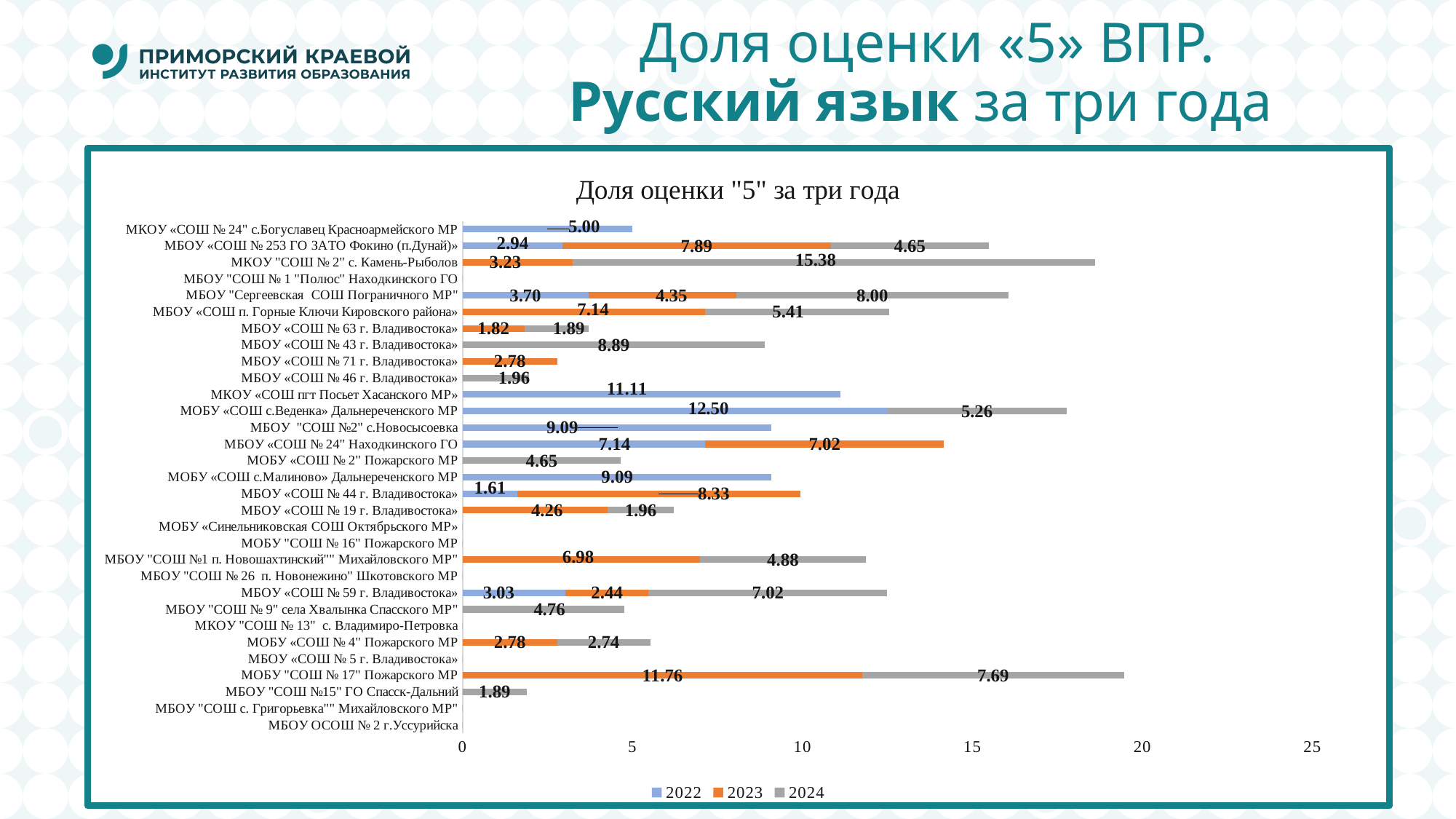
Which school has the highest 2022 value? МОБУ «СОШ с.Веденка» Дальнереченского МР What is the 2023 value for МОБУ "СОШ № 17" Пожарского МР? 11.76 Is the 2022 value for МКОУ «СОШ пгт Посьет Хасанского МР» greater or less than 10? greater How many series does the legend list? 3 What is the total of the stacked bar for МБОУ «СОШ № 253 ГО ЗАТО Фокино (п.Дунай)»? 15.48 What is the 2022 value for МОБУ «СОШ с.Веденка» Дальнереченского МР? 12.50 What is the title of the chart? Доля оценки "5" за три года What is the difference between the 2023 and 2024 values for МОБУ "СОШ № 17" Пожарского МР? 4.07 Which school has the highest 2024 value? МКОУ "СОШ № 2" с. Камень-Рыболов What is the 2024 value for МКОУ "СОШ № 2" с. Камень-Рыболов? 15.38 Which is larger for МБОУ «СОШ № 59 г. Владивостока»: the 2022 value or the 2024 value? 2024 What kind of chart is shown on the slide? bar chart